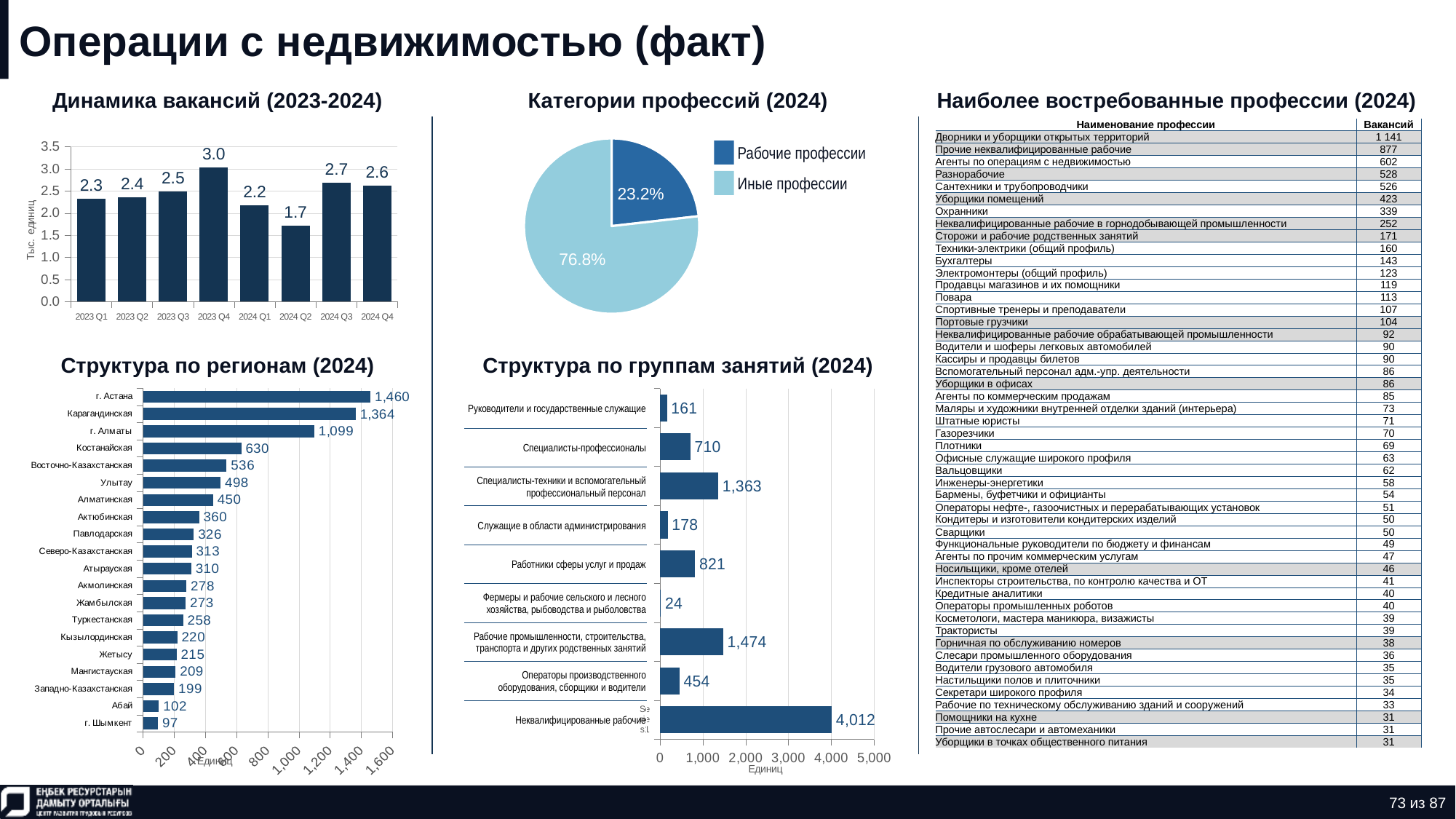
In the chart 'Динамика вакансий (2023-2024)', what is the difference between 2024 Q3 and 2024 Q2? 1.0 In the pie chart 'Категории профессий (2024)', what share is 'Рабочие профессии'? 23.2% In the chart 'Динамика вакансий (2023-2024)', what is the value for 2023 Q4? 3.0 In the chart 'Динамика вакансий (2023-2024)', how many quarters are plotted? 8 In the chart 'Динамика вакансий (2023-2024)', which quarter has the lowest value? 2024 Q2 In the chart 'Структура по регионам (2024)', what is the value for Карагандинская? 1,364 What kind of chart is 'Структура по группам занятий (2024)'? Bar chart In the chart 'Структура по регионам (2024)', which region has the highest value? г. Астана In the pie chart 'Категории профессий (2024)', how many entries does the legend list? 2 In the chart 'Структура по группам занятий (2024)', what is the value for 'Неквалифицированные рабочие'? 4,012 In the chart 'Структура по группам занятий (2024)', which group has the lowest value? Фермеры и рабочие сельского и лесного хозяйства, рыбоводства и рыболовства In the chart 'Структура по регионам (2024)', which is larger: Костанайская or Восточно-Казахстанская? Костанайская